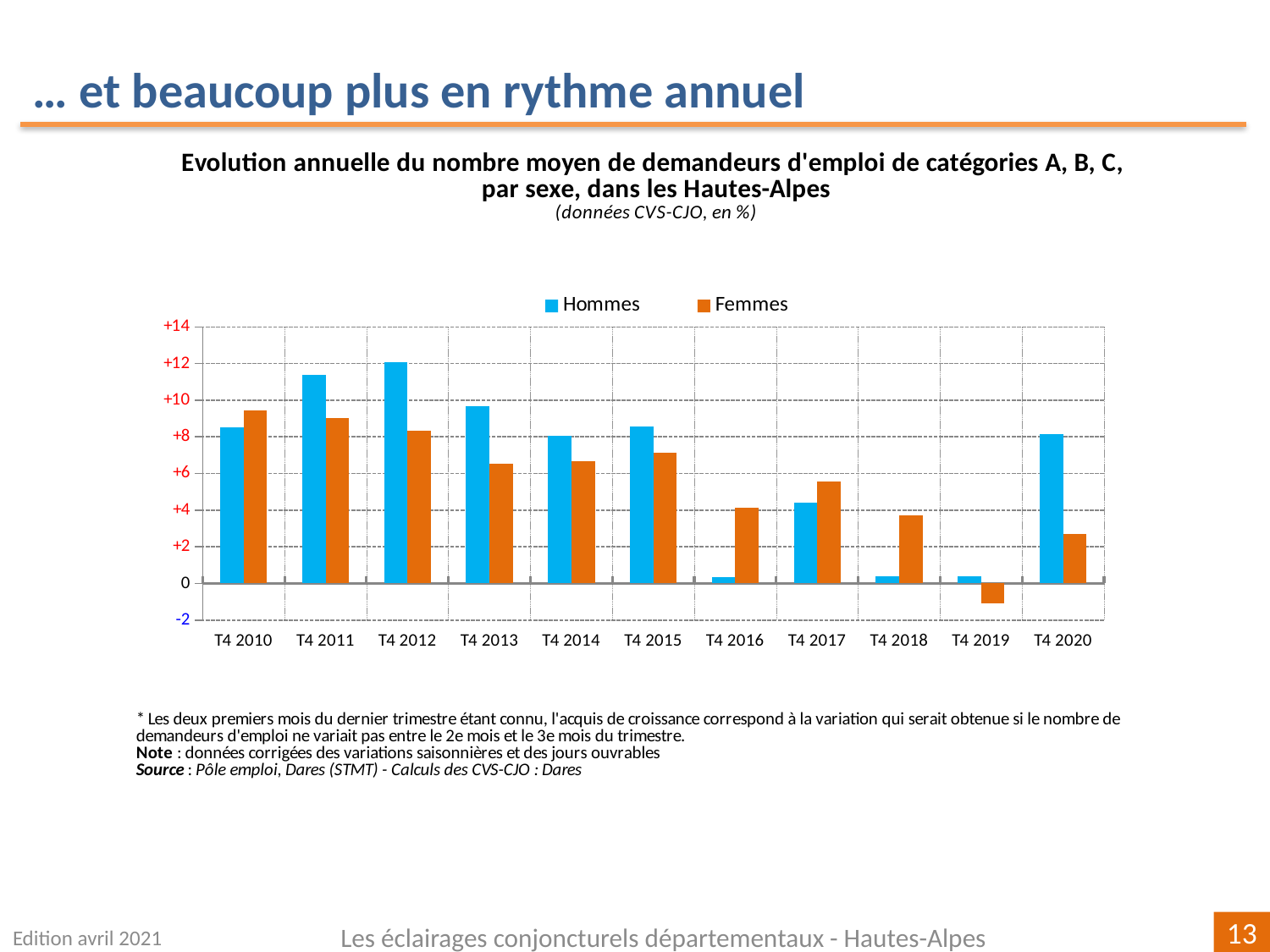
In which quarter is the value for Femmes the lowest? T4 2019 In which quarter is the value for Hommes the highest? T4 2012 How many quarters (categories) are shown on the x axis? 11 Is the value for Hommes in T4 2012 greater or less than +10? greater Is the value for Femmes in T4 2016 greater or less than +2? greater Is the value for Femmes in T4 2019 greater or less than 0? less What kind of chart is shown on the slide? bar chart Which colour represents the Femmes series in the chart? orange How many series does the legend list? 2 In T4 2016, which series has the larger value, Hommes or Femmes? Femmes In T4 2020, which series has the larger value, Hommes or Femmes? Hommes